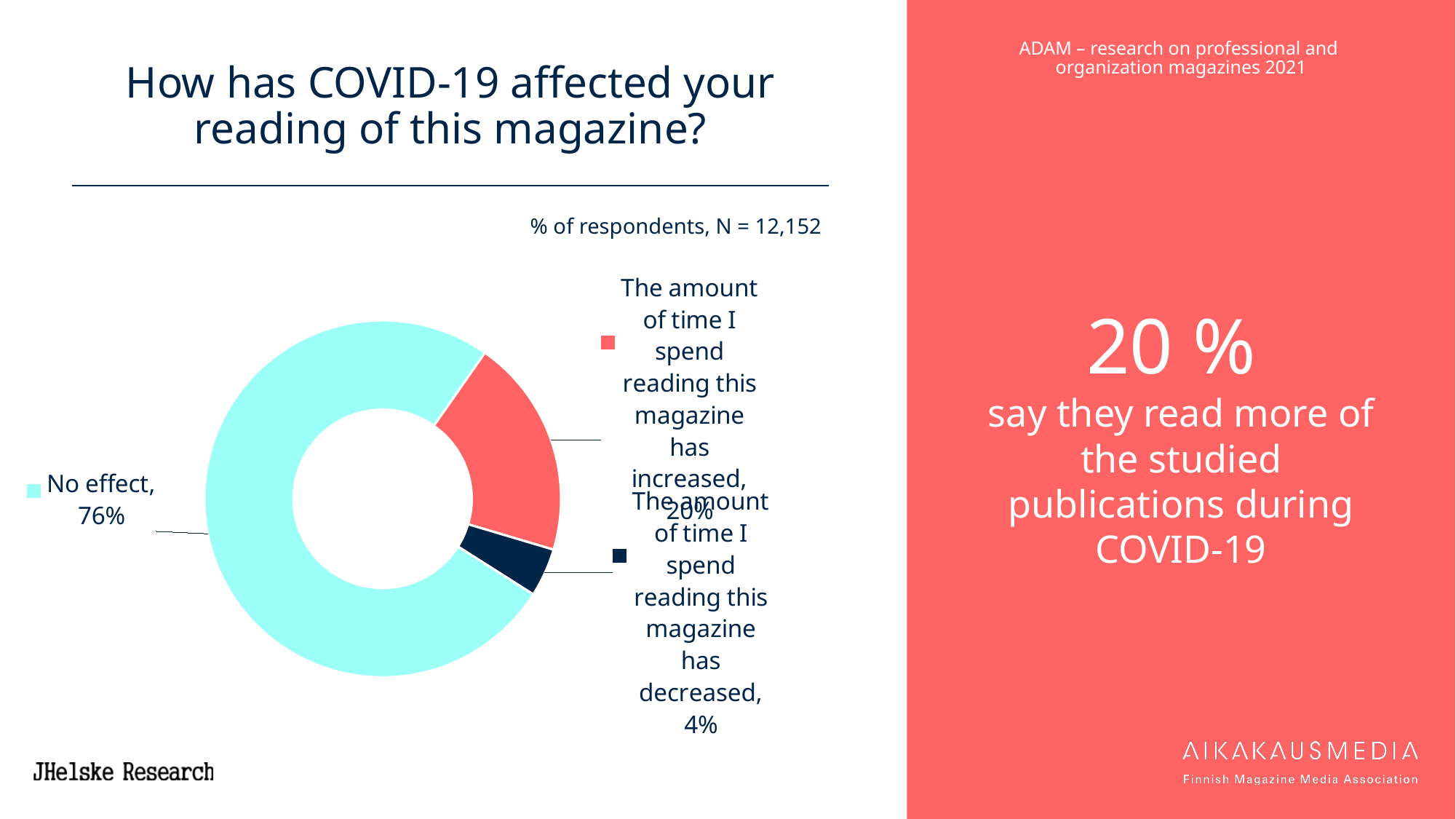
What percentage of respondents said the amount of time they spend reading this magazine has increased? 20% What is the difference in percentage points between respondents reporting increased reading time and those reporting decreased reading time? 16 What percentage of respondents said COVID-19 had no effect on their reading of this magazine? 76% What percentage of respondents said the amount of time they spend reading this magazine has decreased? 4% How many response categories are shown in the chart? 3 Which is larger: the share reporting increased reading time or the share reporting decreased reading time? Increased reading time Which response category has the smallest share of respondents? The amount of time I spend reading this magazine has decreased Which response category has the largest share of respondents? No effect What colour is the 'No effect' slice of the chart? Light turquoise What is the difference in percentage points between respondents reporting no effect and those reporting increased reading time? 56 How many respondents (N) does the chart subtitle state? 12,152 What kind of chart is used on this slide? Donut (pie) chart